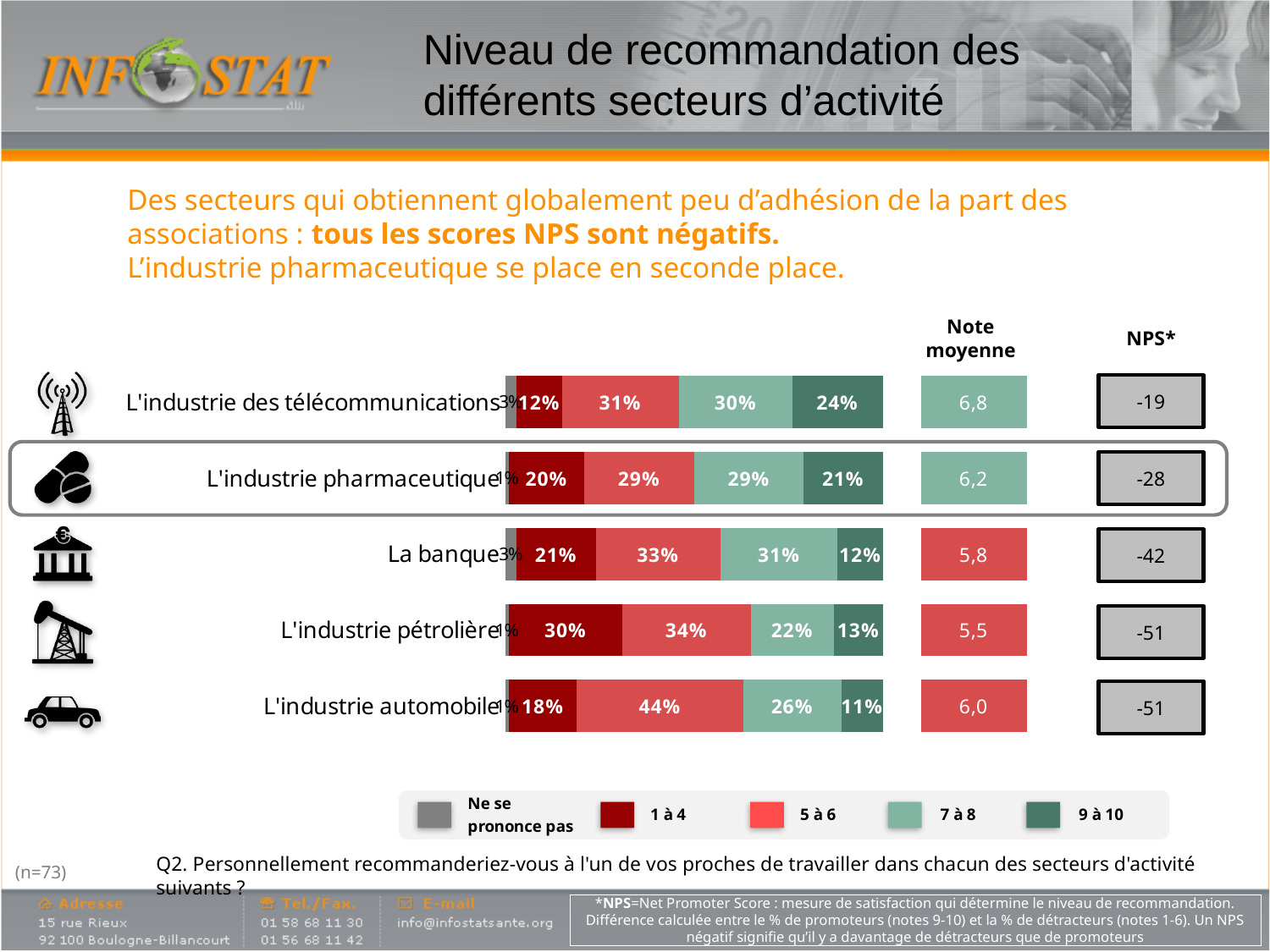
Which is larger: the '7 à 8' value for La banque or for L'industrie pétrolière? La banque What is the value of the '5 à 6' segment for L'industrie automobile? 44% How many series does the legend list? 5 How many sectors (categories) are plotted in the chart? 5 What kind of chart is shown on the slide? Stacked bar chart Which sector has the highest '9 à 10' value? L'industrie des télécommunications Which sector has the lowest '9 à 10' value? L'industrie automobile What is the 'Note moyenne' shown for L'industrie pharmaceutique? 6,2 What NPS* value is shown for La banque? -42 What is the value of the '1 à 4' segment for L'industrie pétrolière? 30% What is the difference between the '5 à 6' values for L'industrie automobile and La banque? 11% What is the value of the '9 à 10' segment for L'industrie des télécommunications? 24%